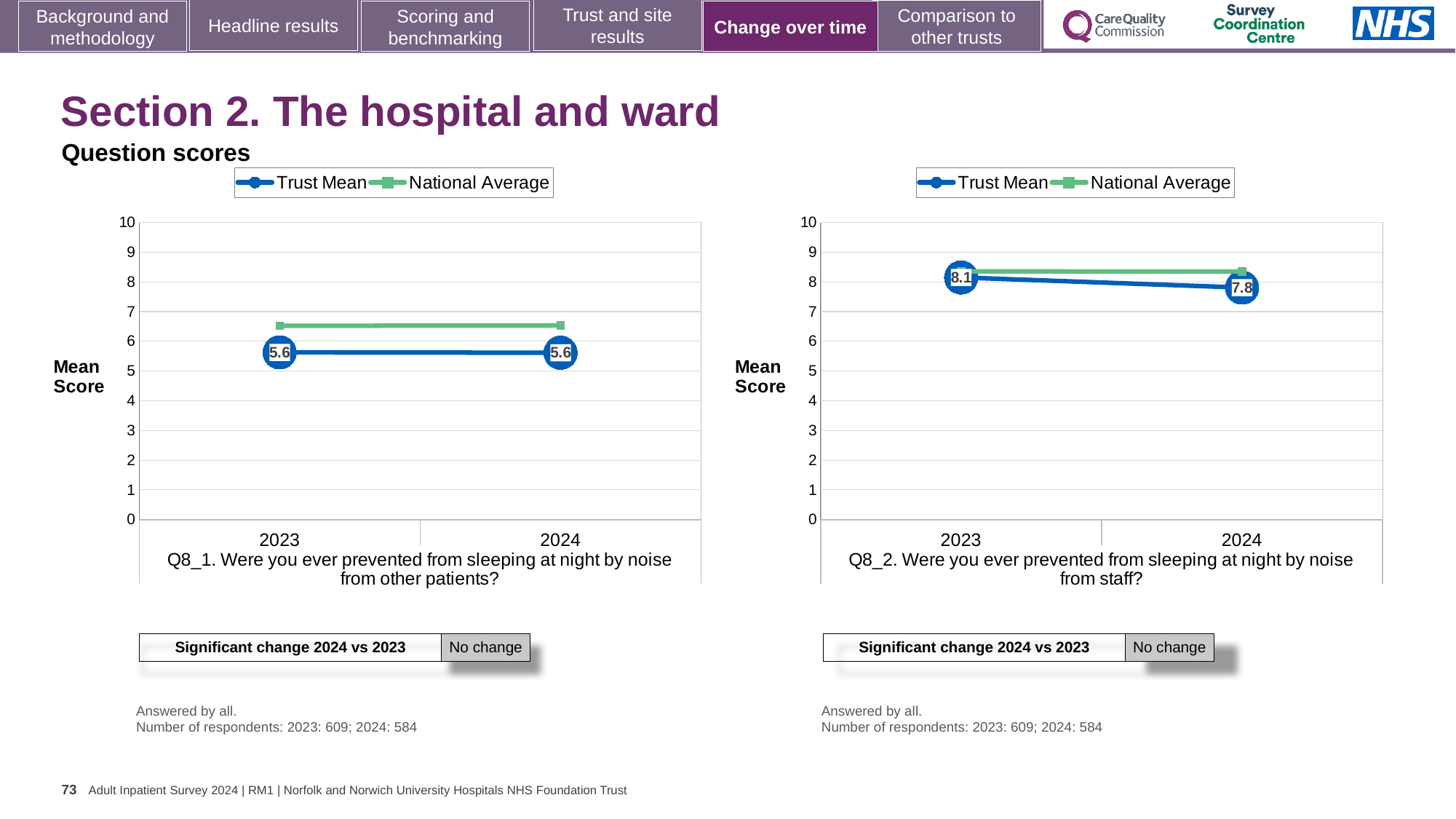
In the Q8_2 chart (right), what is the difference between the Trust Mean scores for 2023 and 2024? 0.3 In the Q8_1 chart (left), what is the Trust Mean score for 2024? 5.6 In the Q8_2 chart (right), which year has the higher Trust Mean score, 2023 or 2024? 2023 In the Q8_1 chart (left), is the National Average value for 2024 greater or less than 6? greater In the Q8_2 chart (right), what is the Trust Mean score for 2024? 7.8 In the Q8_1 chart (left), what is the Trust Mean score for 2023? 5.6 In the Q8_2 chart (right), what is the Trust Mean score for 2023? 8.1 In the Q8_2 chart (right), is the National Average value for 2023 greater or less than 8? greater In the Q8_2 chart (right), does the Trust Mean rise or fall from 2023 to 2024? fall What kind of chart is the Q8_2 chart (right)? line chart In the Q8_1 chart (left), does the Trust Mean rise, fall or stay the same from 2023 to 2024? stays the same How many series does the legend of the Q8_1 chart (left) list? 2